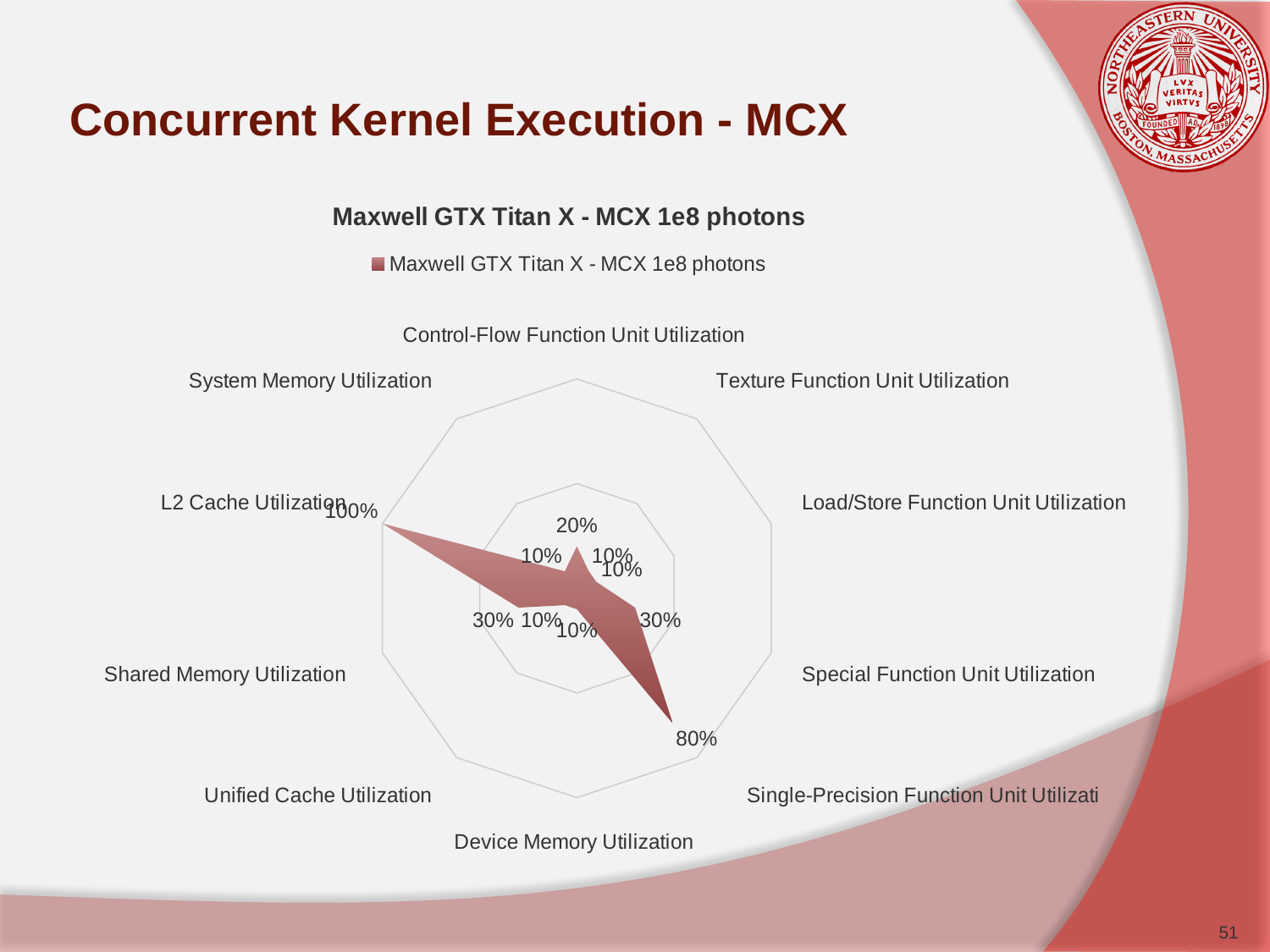
Which is larger, Special Function Unit Utilization or Texture Function Unit Utilization? Special Function Unit Utilization What is the value for Special Function Unit Utilization? 30% What is the value for Control-Flow Function Unit Utilization? 20% What is the value for Shared Memory Utilization? 30% How many categories are plotted on the radar chart? 10 What type of chart is shown on the slide? Radar chart How many series does the legend list? 1 What is the value for L2 Cache Utilization? 100% What is the title of the chart? Maxwell GTX Titan X - MCX 1e8 photons What is the difference between L2 Cache Utilization and Single-Precision Function Unit Utilization? 20% What is the value for Single-Precision Function Unit Utilization? 80% Which category has the highest value? L2 Cache Utilization